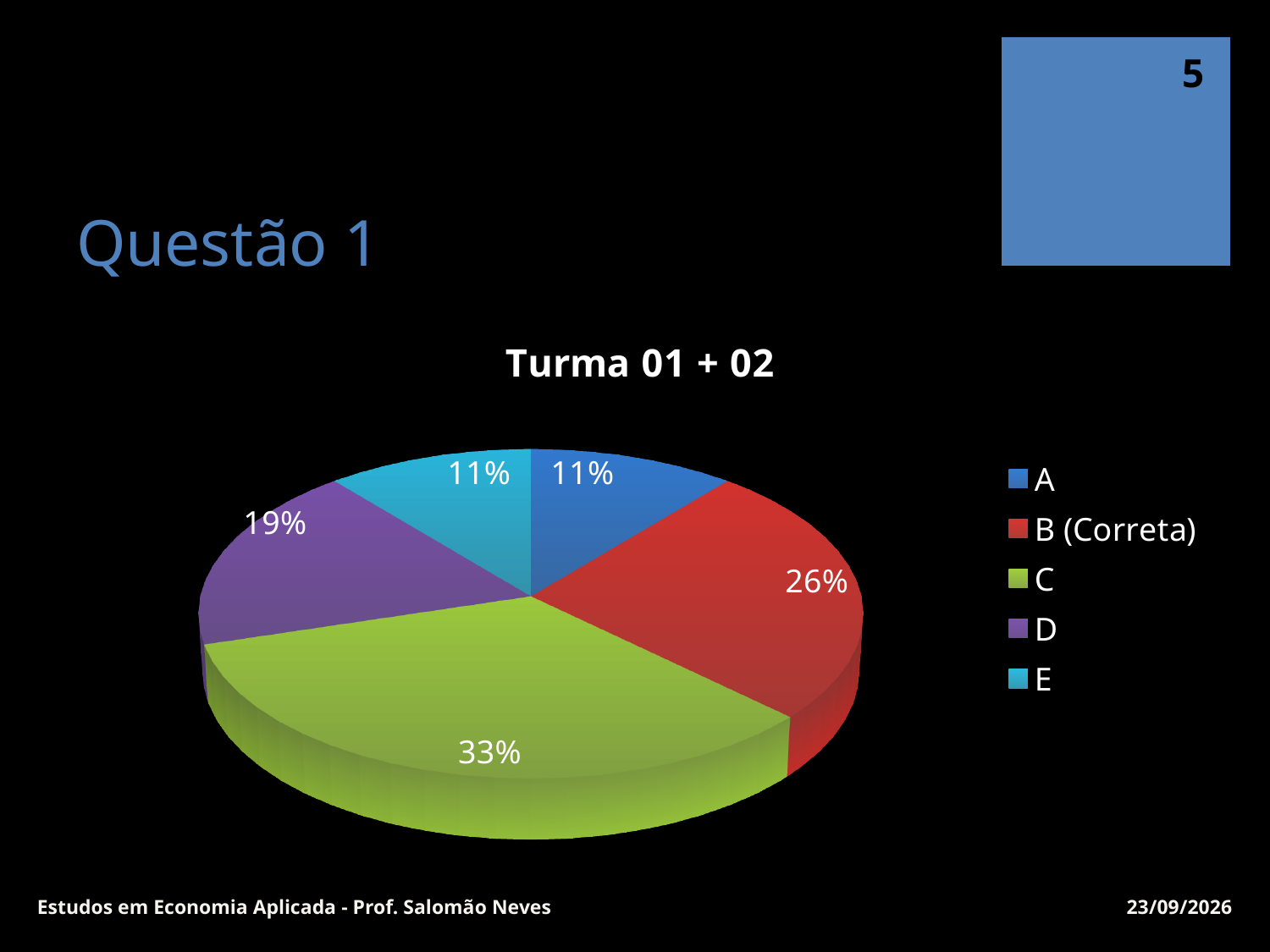
What percentage of the pie does slice A represent? 11% What is the difference in percentage points between slice D and slice E? 8 Which category has the largest share of the pie? C What type of chart is shown on the slide? pie chart How many categories does the legend list? 5 What percentage of the pie does slice B (Correta) represent? 26% What percentage of the pie does slice D represent? 19% Which slice is larger, D or E? D What is the title of the chart? Turma 01 + 02 Which legend entry is marked as the correct answer? B (Correta) What percentage of the pie does slice C represent? 33% What is the difference in percentage points between slice C and slice B (Correta)? 7